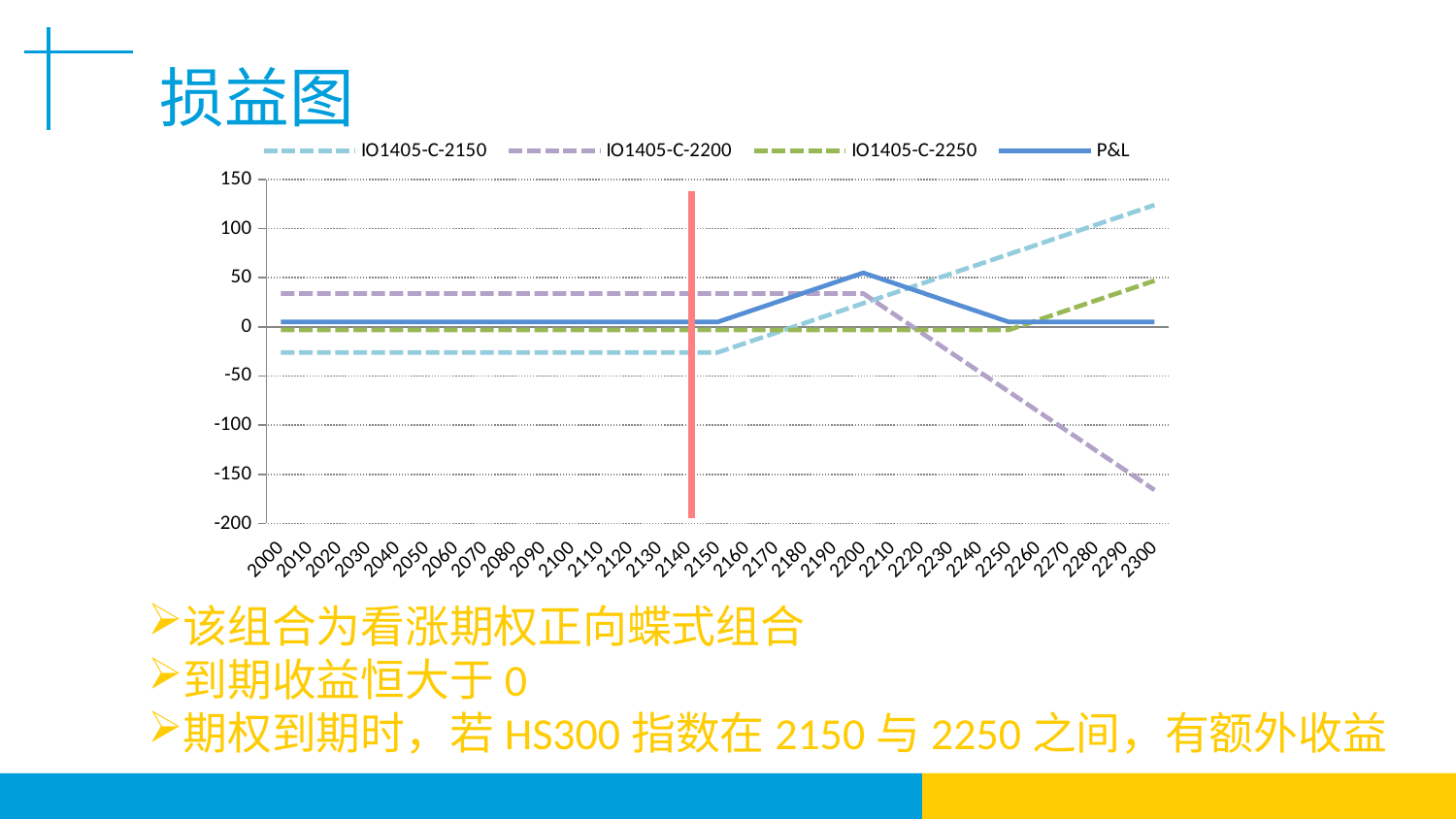
Which series has the lowest value at 2300? IO1405-C-2200 What is the title of the chart? 损益图 Is the value of IO1405-C-2200 at 2300 greater or less than -150? less Is the value of IO1405-C-2250 at 2300 greater or less than 0? greater Is the value of IO1405-C-2150 at 2000 greater or less than 0? less Does the IO1405-C-2200 series rise or fall from 2200 to 2300? fall How many series does the legend list? 4 Which series has the highest value at 2300? IO1405-C-2150 At 2000, which is larger: IO1405-C-2200 or IO1405-C-2150? IO1405-C-2200 How many x-axis categories are shown on the chart? 31 What kind of chart is shown on the slide? line chart